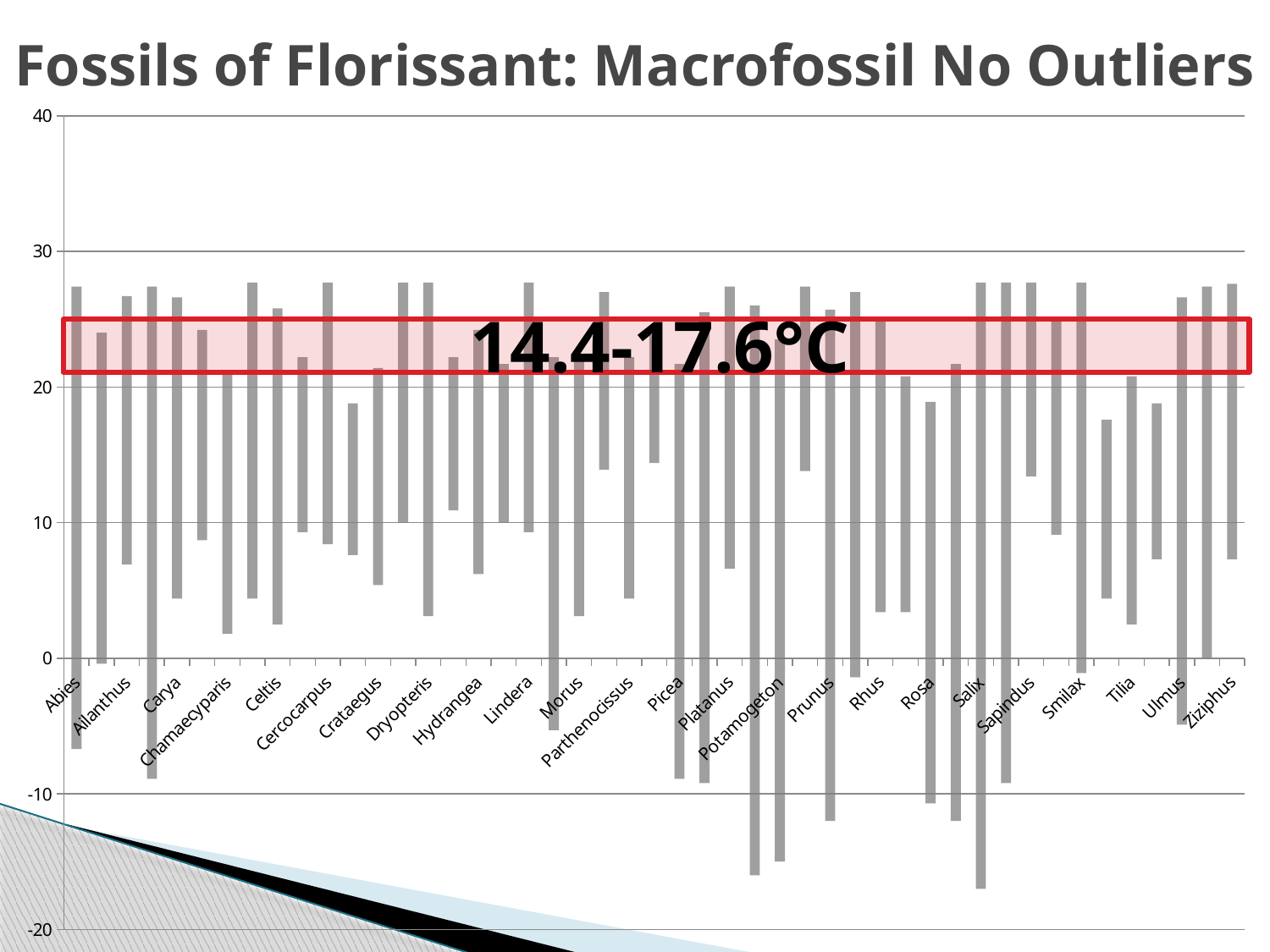
Is the bottom of the bar for Sapindus greater or less than 10? greater Is the top of the bar for Tilia greater or less than 30? less Is the bottom of the bar for Rosa greater or less than 0? less What is the title of the chart on the slide? Fossils of Florissant: Macrofossil No Outliers What kind of chart is shown on the slide? bar chart What temperature range is written in the highlighted band across the chart? 14.4-17.6°C